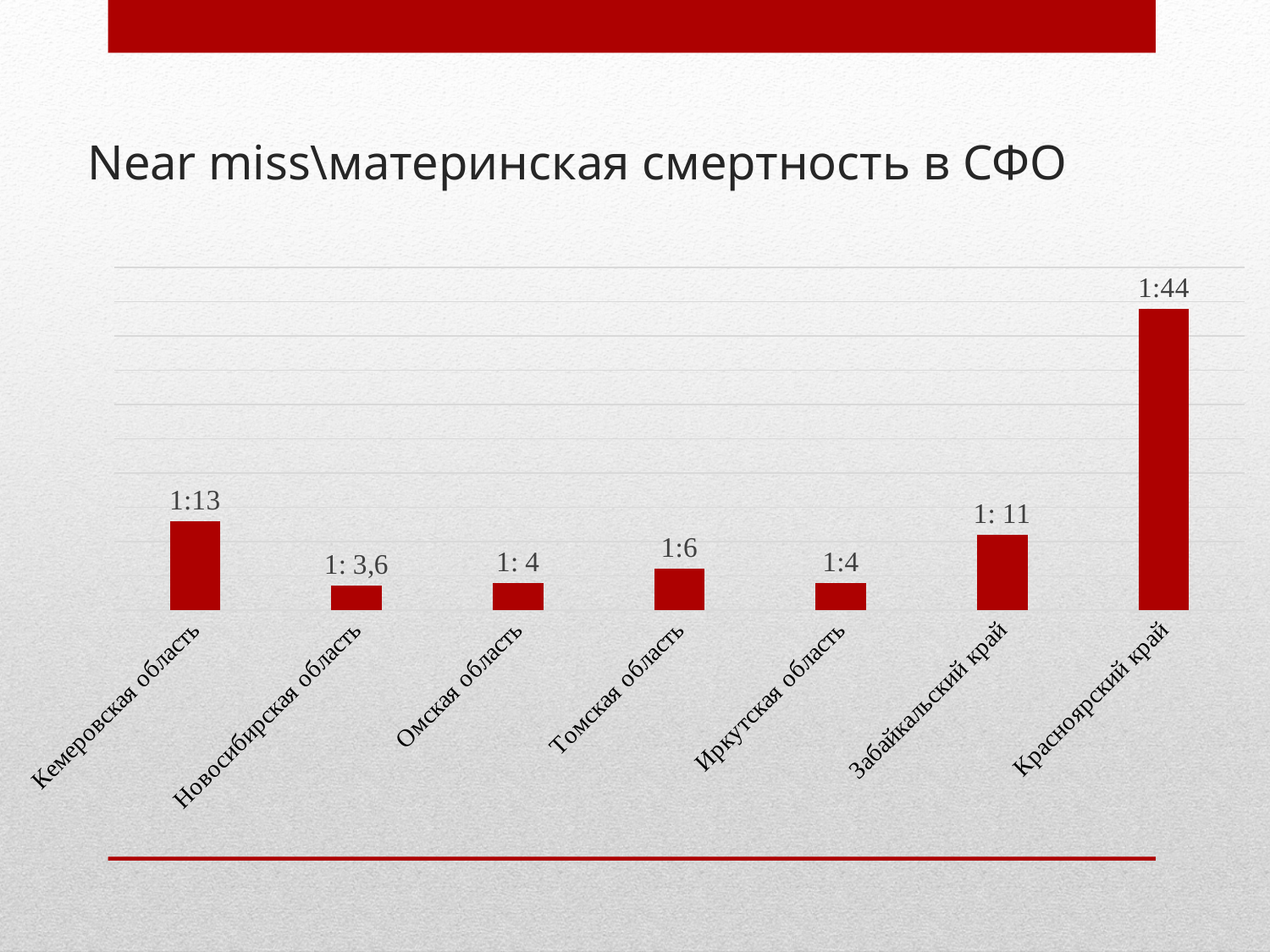
What is the title of the slide? Near miss\материнская смертность в СФО What value is shown for Томская область? 1:6 How many regions are shown on the chart? 7 Which region has the shortest bar? Новосибирская область What value is shown for Новосибирская область? 1: 3,6 Which bar is taller: Кемеровская область or Забайкальский край? Кемеровская область What kind of chart is shown on the slide? Bar chart What value is shown for Красноярский край? 1:44 What value is shown for Забайкальский край? 1: 11 Which region has the tallest bar? Красноярский край What value is shown for Иркутская область? 1:4 What value is shown for Кемеровская область? 1:13